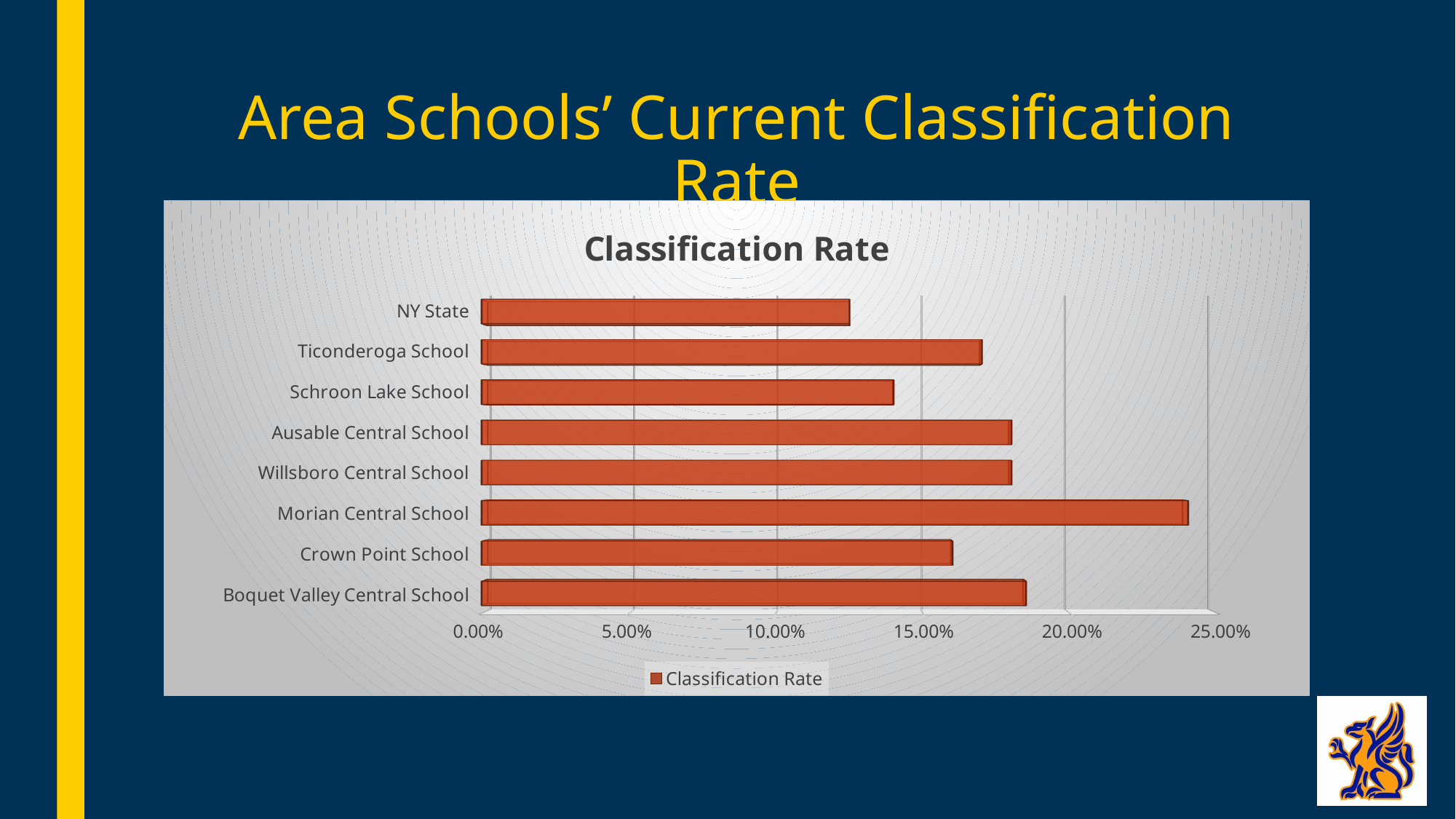
Is the value for NY State greater or less than 15.00%? less What kind of chart is shown on the slide? Bar chart Is the value for Schroon Lake School greater or less than 10.00%? greater Which category has the lowest classification rate? NY State How many series does the legend of the Classification Rate chart list? 1 Is the value for Ticonderoga School greater or less than 20.00%? less Which category has the highest classification rate? Morian Central School How many categories are plotted in the Classification Rate chart? 8 Which has a higher classification rate, Ticonderoga School or Schroon Lake School? Ticonderoga School What is the title of the chart? Classification Rate Which has a higher classification rate, Crown Point School or Boquet Valley Central School? Boquet Valley Central School